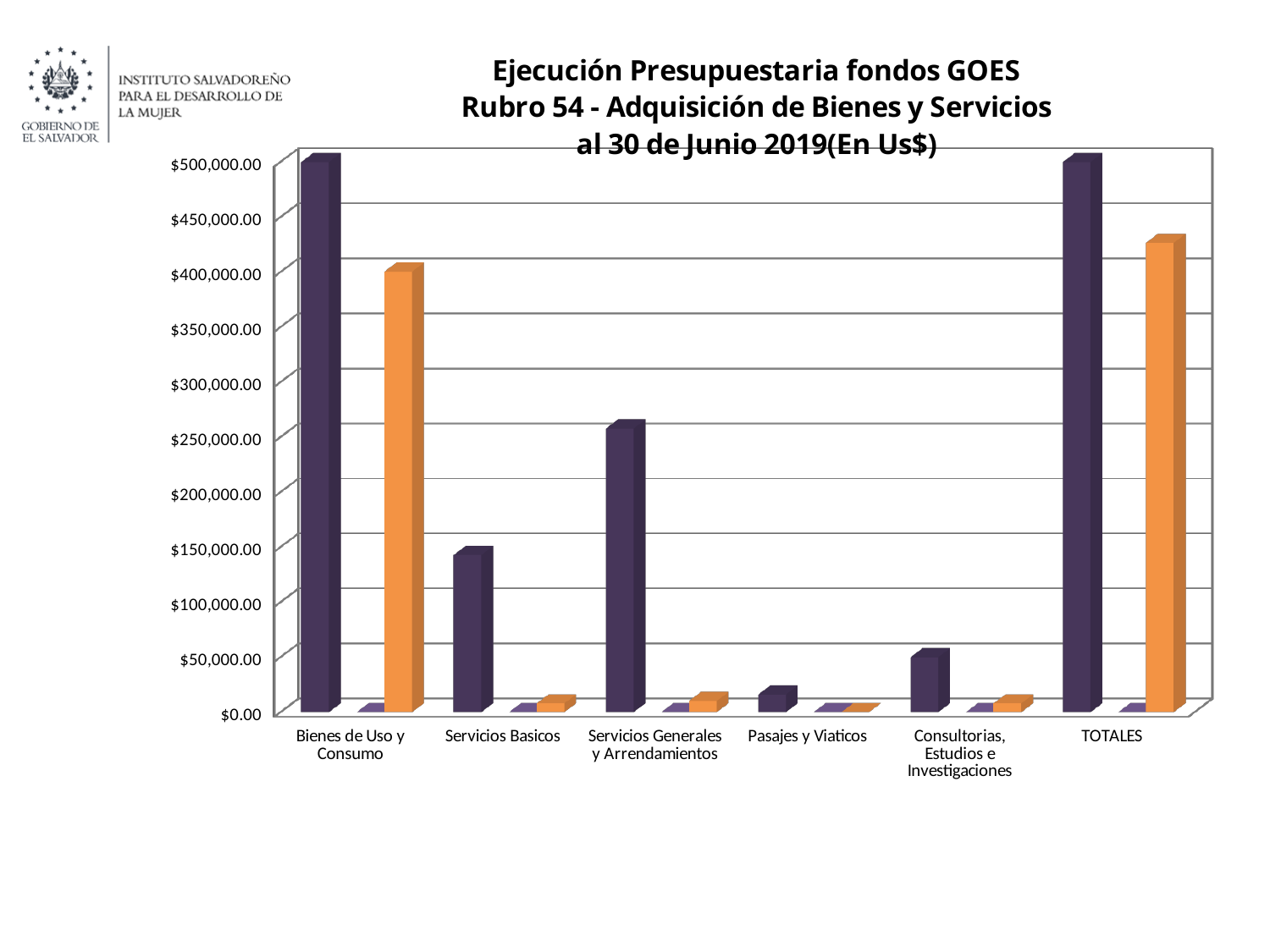
Is the dark purple bar for Pasajes y Viaticos greater or less than $50,000.00? less How many categories are shown along the x axis of the chart? 6 Among the dark purple bars, which category has the lowest value? Pasajes y Viaticos What is the title of the chart? Ejecución Presupuestaria fondos GOES Rubro 54 - Adquisición de Bienes y Servicios al 30 de Junio 2019(En Us$) Which dark purple bar is larger: Servicios Generales y Arrendamientos or Servicios Basicos? Servicios Generales y Arrendamientos Is the dark purple bar for Servicios Generales y Arrendamientos greater or less than $200,000.00? greater Is the orange bar for TOTALES greater or less than $400,000.00? greater What kind of chart is shown on the slide? bar chart Which orange bar is larger: Bienes de Uso y Consumo or Servicios Basicos? Bienes de Uso y Consumo